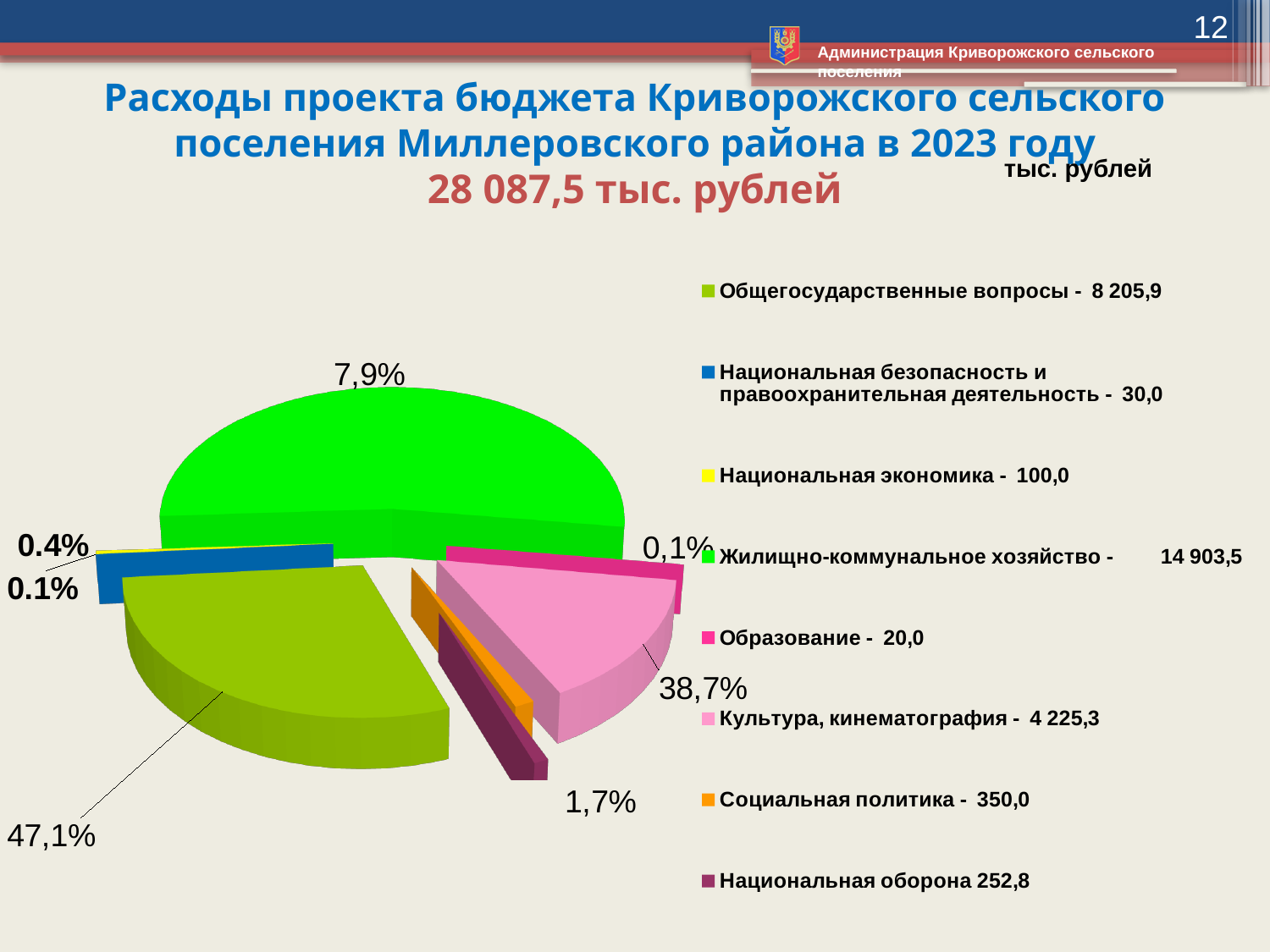
How many expenditure categories does the legend of the pie chart list? 8 Which has the larger value, Социальная политика or Национальная оборона? Социальная политика What is the value shown in the legend for Общегосударственные вопросы? 8 205,9 What type of chart is shown on the slide? pie chart What is the difference between the values for Жилищно-коммунальное хозяйство and Общегосударственные вопросы? 6 697,6 Which category has the largest value in the legend? Жилищно-коммунальное хозяйство Which category has the smallest value in the legend? Образование What is the value shown in the legend for Жилищно-коммунальное хозяйство? 14 903,5 What is the largest percentage label printed on the pie chart? 47,1% What is the value shown in the legend for Культура, кинематография? 4 225,3 What total expenditure amount is stated in the slide title? 28 087,5 тыс. рублей What is the value shown in the legend for Национальная оборона? 252,8